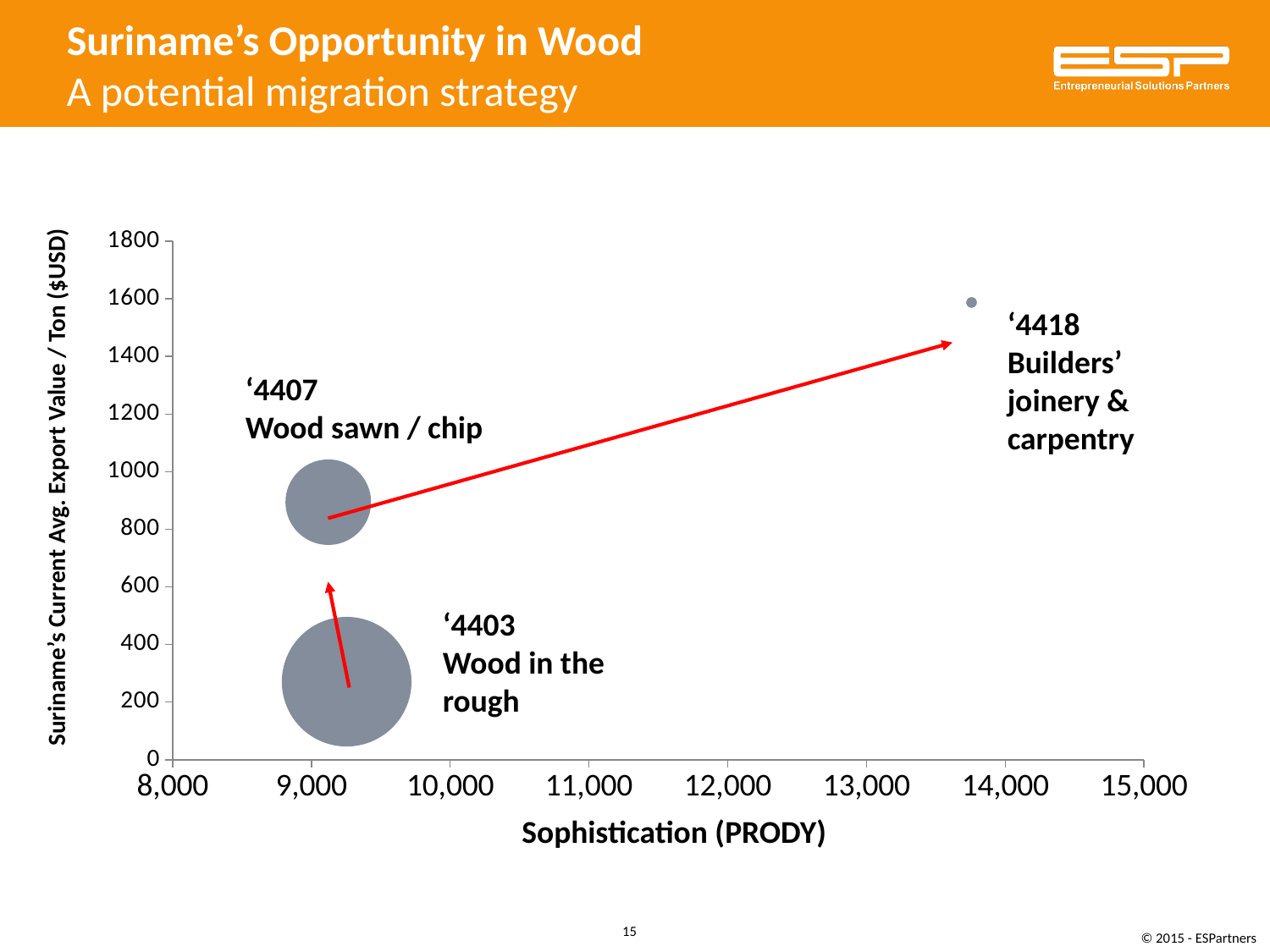
Is the Sophistication (PRODY) for '4418 Builders' joinery & carpentry greater or less than 13,000? greater Which product has the highest Sophistication (PRODY)? '4418 Builders' joinery & carpentry Is the export value per ton for '4403 Wood in the rough greater or less than 400? less Which product is represented by the largest bubble? '4403 Wood in the rough Is the export value per ton for '4407 Wood sawn / chip greater or less than 600? greater Which product has the highest Suriname's Current Avg. Export Value / Ton? '4418 Builders' joinery & carpentry What kind of chart is shown on the slide? bubble chart What is the label of the x axis? Sophistication (PRODY) Which has a higher export value per ton: '4407 Wood sawn / chip or '4403 Wood in the rough? '4407 Wood sawn / chip How many products (bubbles) are plotted on the chart? 3 Which product has the lowest Suriname's Current Avg. Export Value / Ton? '4403 Wood in the rough